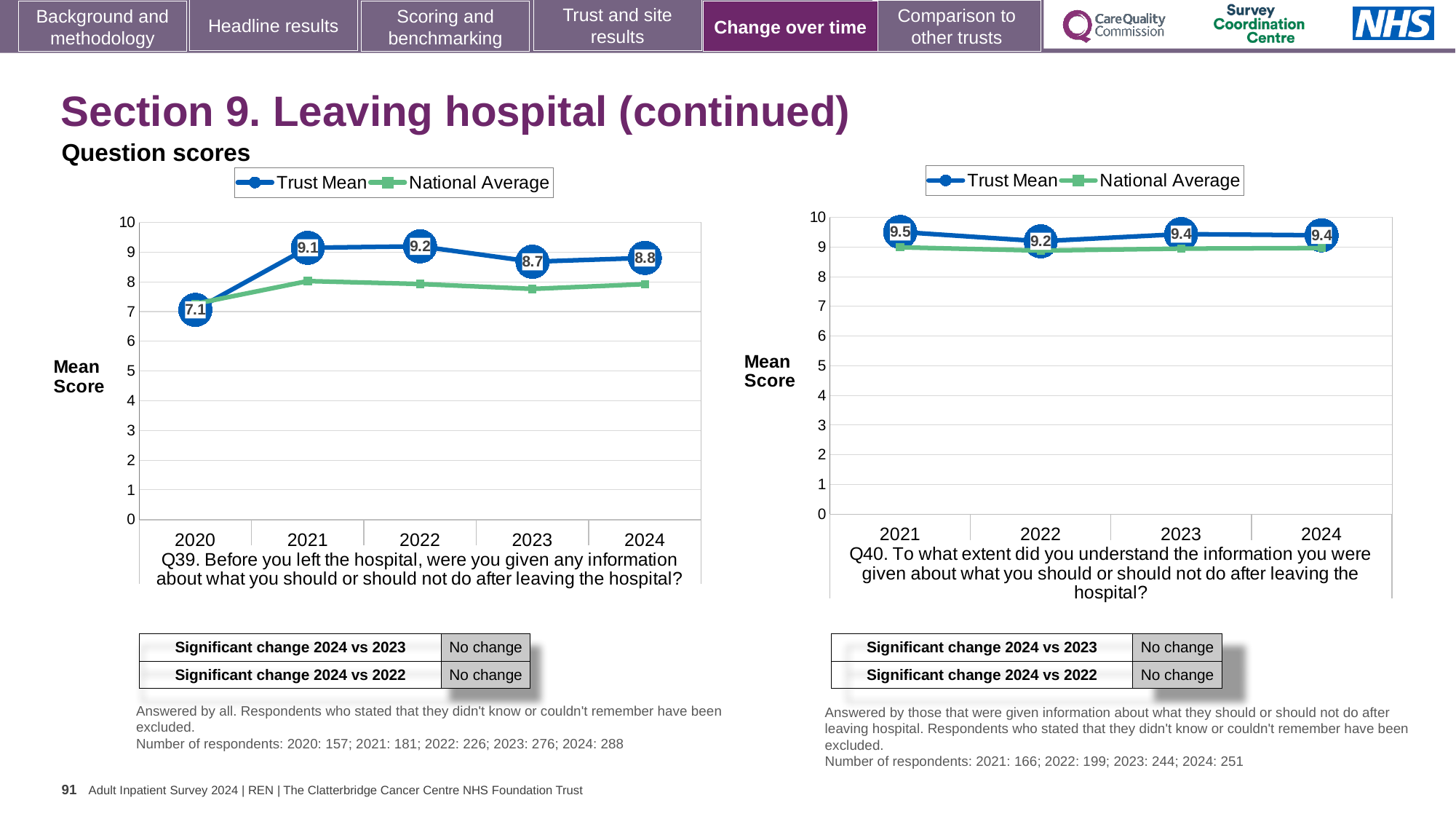
In the Q39 chart (left), which year has the lowest Trust Mean score? 2020 In the Q39 chart (left), is the National Average for 2024 greater or less than 9? less In the Q40 chart (right), which year has the lowest Trust Mean score? 2022 In the Q39 chart (left), which year has the highest Trust Mean score? 2022 In the Q40 chart (right), what is the Trust Mean score for 2021? 9.5 In the Q39 chart (left), what is the Trust Mean score for 2023? 8.7 In the Q39 chart (left), how many years are plotted on the x axis? 5 In the Q40 chart (right), is the Trust Mean for 2022 higher or lower than the Trust Mean for 2021? lower In the Q39 chart (left), what is the Trust Mean score for 2020? 7.1 What type of chart is used for the Q40 chart (right)? line chart In the Q39 chart (left), what is the difference between the Trust Mean scores for 2021 and 2020? 2.0 In the Q40 chart (right), how many series does the legend list? 2